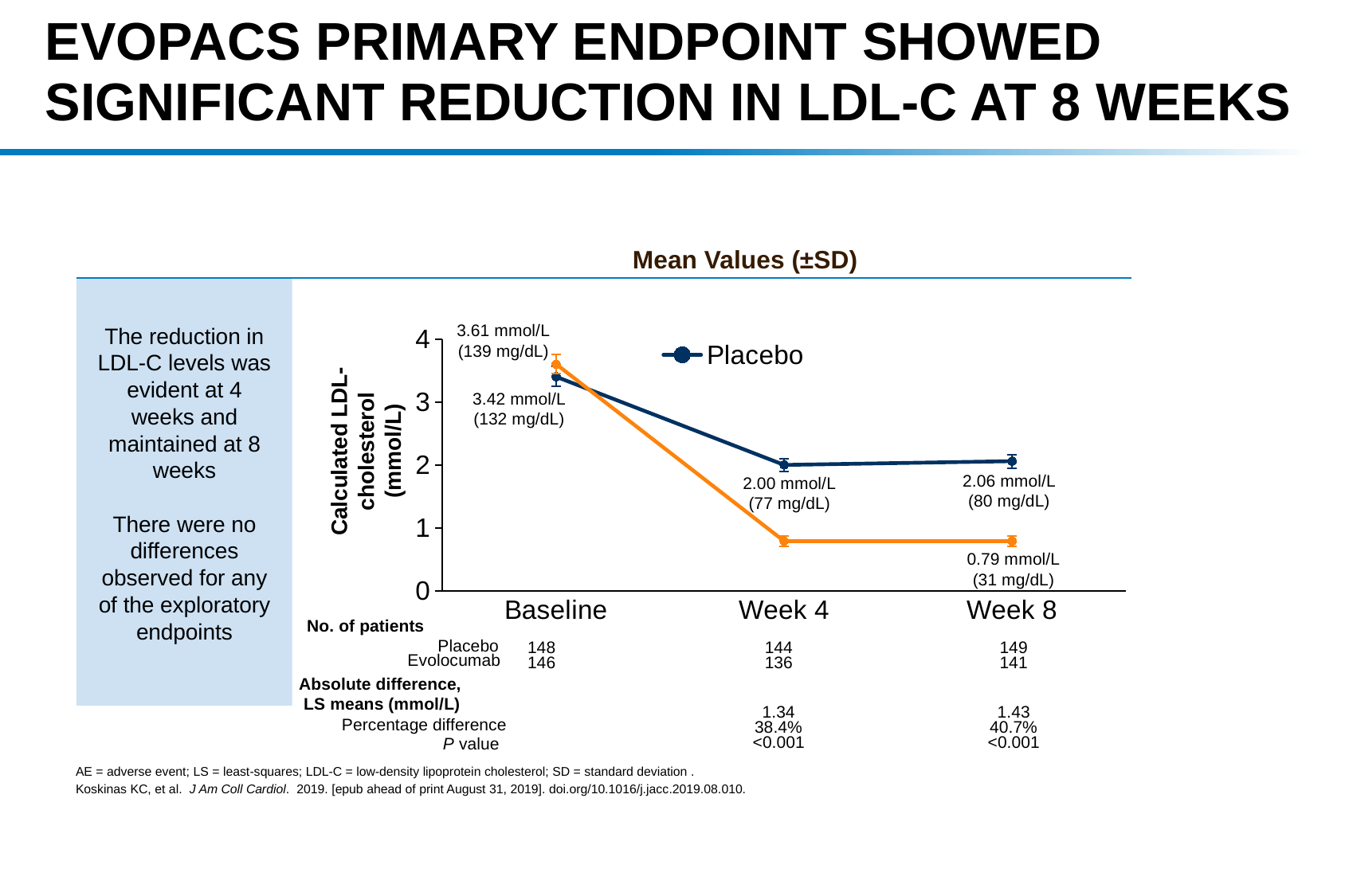
What is the mean LDL-C value for Placebo at Baseline? 3.42 mmol/L Is the value of the orange line at Week 4 greater or less than 1? less How many time points are plotted on the x axis? 3 What is the Placebo value at Week 8 expressed in mg/dL? 80 mg/dL What is the mean LDL-C value for the orange line (evolocumab) at Week 8? 0.79 mmol/L How many series does the legend list? 1 Does the Placebo line rise or fall from Baseline to Week 4? fall What is the mean LDL-C value for Placebo at Week 4? 2.00 mmol/L By how much does the Placebo value fall from Baseline to Week 8, in mmol/L? 1.36 mmol/L What is the title of the chart? Mean Values (±SD) What kind of chart is shown on the slide? line chart At Baseline, which line has the higher value, Placebo or the orange line? the orange line